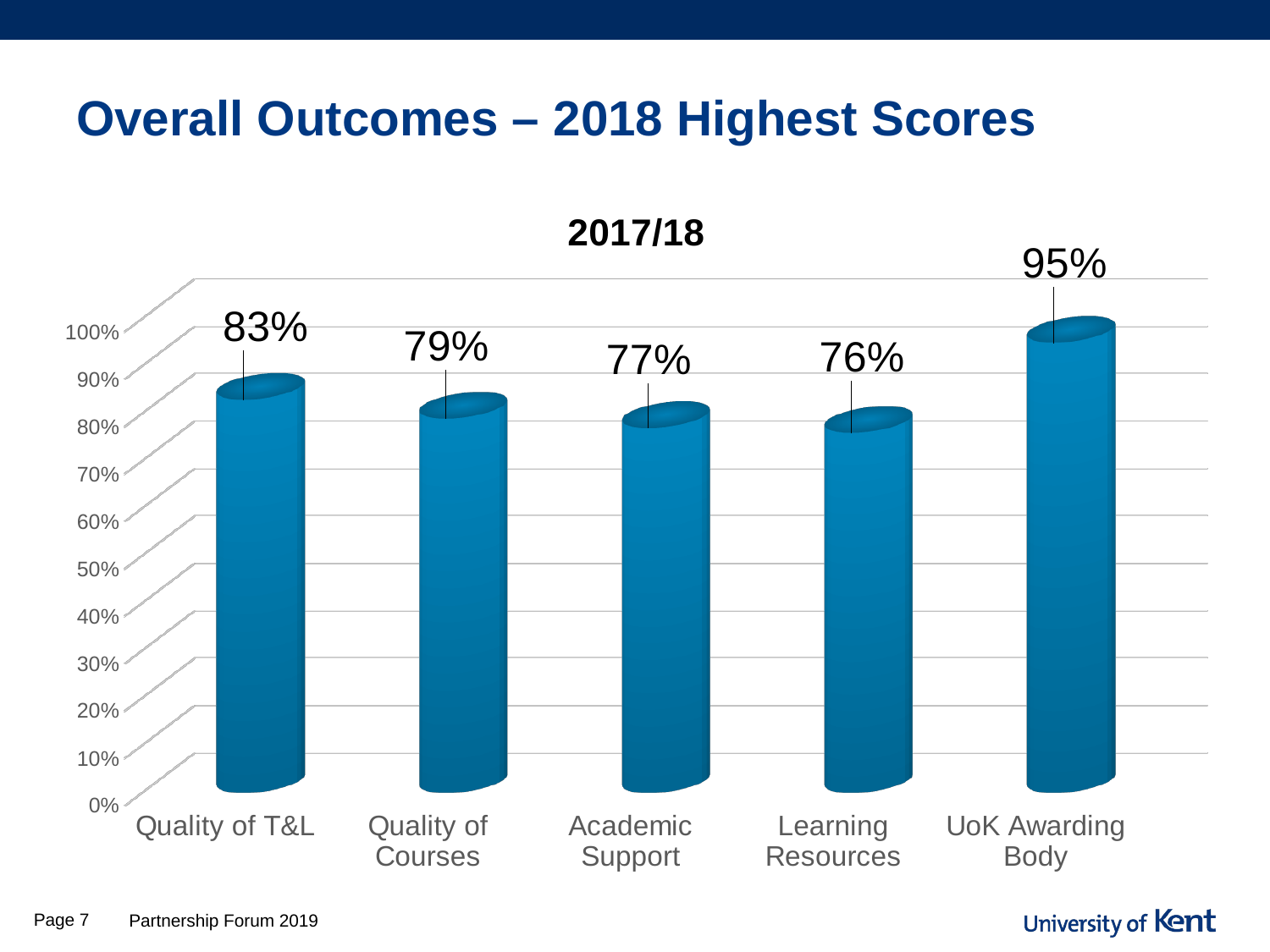
Which category has the highest value? UoK Awarding Body What is the value for UoK Awarding Body? 95% Which is larger, the value for Quality of T&L or the value for Quality of Courses? Quality of T&L What is the value for Learning Resources? 76% What kind of chart is shown on the slide? Bar chart Which category has the lowest value? Learning Resources What is the title of the chart? 2017/18 What is the value for Quality of T&L? 83% What is the difference between the values for Quality of Courses and Learning Resources? 3% What is the difference between the values for UoK Awarding Body and Quality of T&L? 12% What is the value for Academic Support? 77% How many categories are shown on the chart? 5